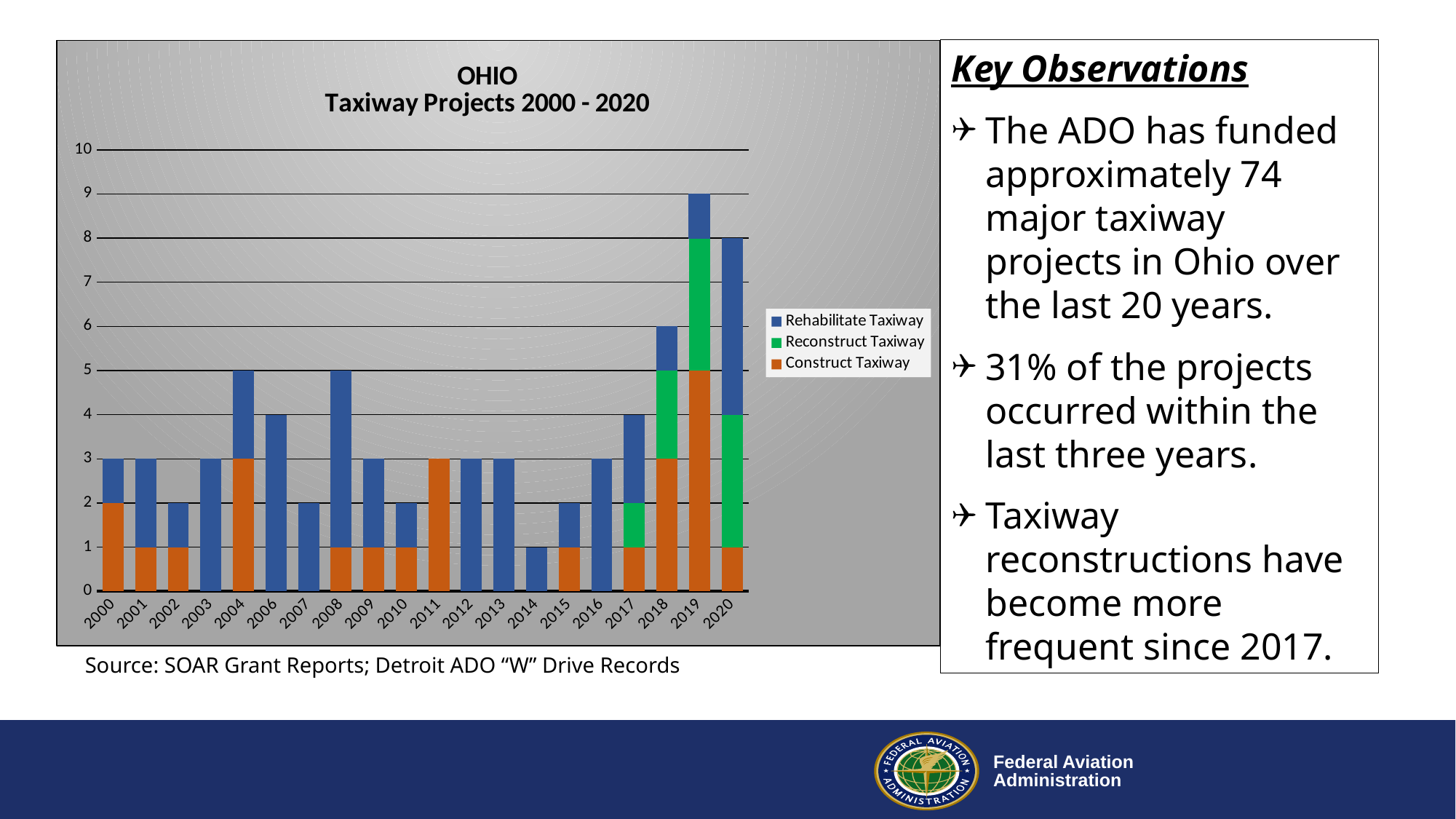
Which series is shown in green in the legend? Reconstruct Taxiway What is the total number of taxiway projects in 2020? 8 What is the difference between the total number of projects in 2019 and in 2014? 8 How many Construct Taxiway projects were there in 2011? 3 Which year has the lowest total number of taxiway projects? 2014 How many series does the legend list? 3 How many Construct Taxiway projects were there in 2019? 5 What kind of chart is shown on the slide? Stacked bar chart Which year has more total taxiway projects, 2018 or 2008? 2018 Which year has the highest total number of taxiway projects? 2019 How many years are shown on the x axis of the chart? 20 What is the total number of taxiway projects in 2019? 9